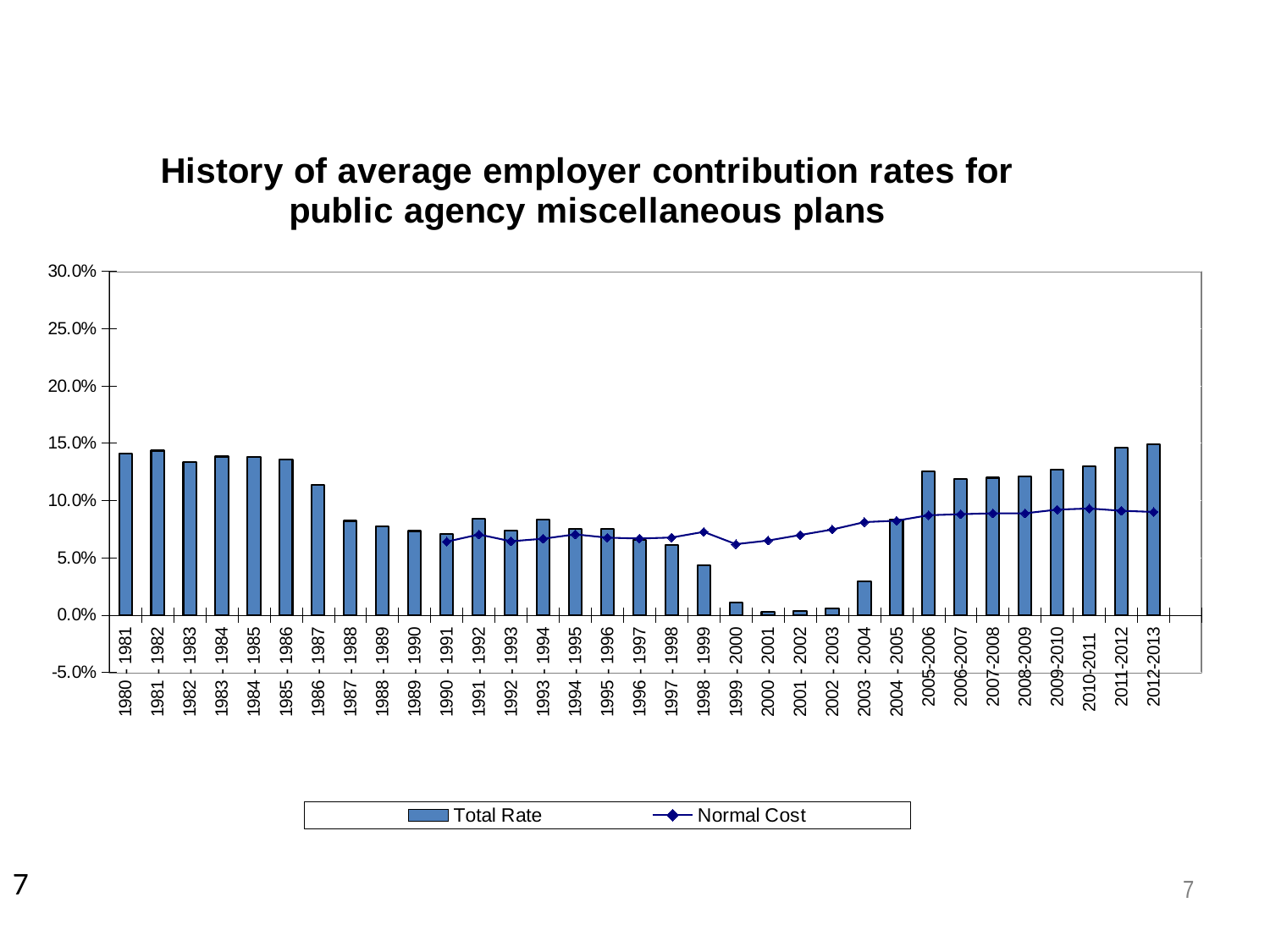
How many fiscal-year categories are shown on the x axis? 33 Is the Total Rate for 1998 - 1999 greater or less than 5.0%? less Is the Total Rate for 2003 - 2004 greater or less than 5.0%? less What are the two series named in the legend? Total Rate and Normal Cost How many series does the legend list? 2 Is the Normal Cost for 2010-2011 greater or less than 10.0%? less What kind of chart is shown on the slide? A bar chart with a line series overlaid In 2000 - 2001, which is larger, the Total Rate or the Normal Cost? Normal Cost Does the Total Rate rise or fall from 2004 - 2005 to 2012-2013? rise Which is larger, the Total Rate for 1980 - 1981 or the Total Rate for 1987 - 1988? 1980 - 1981